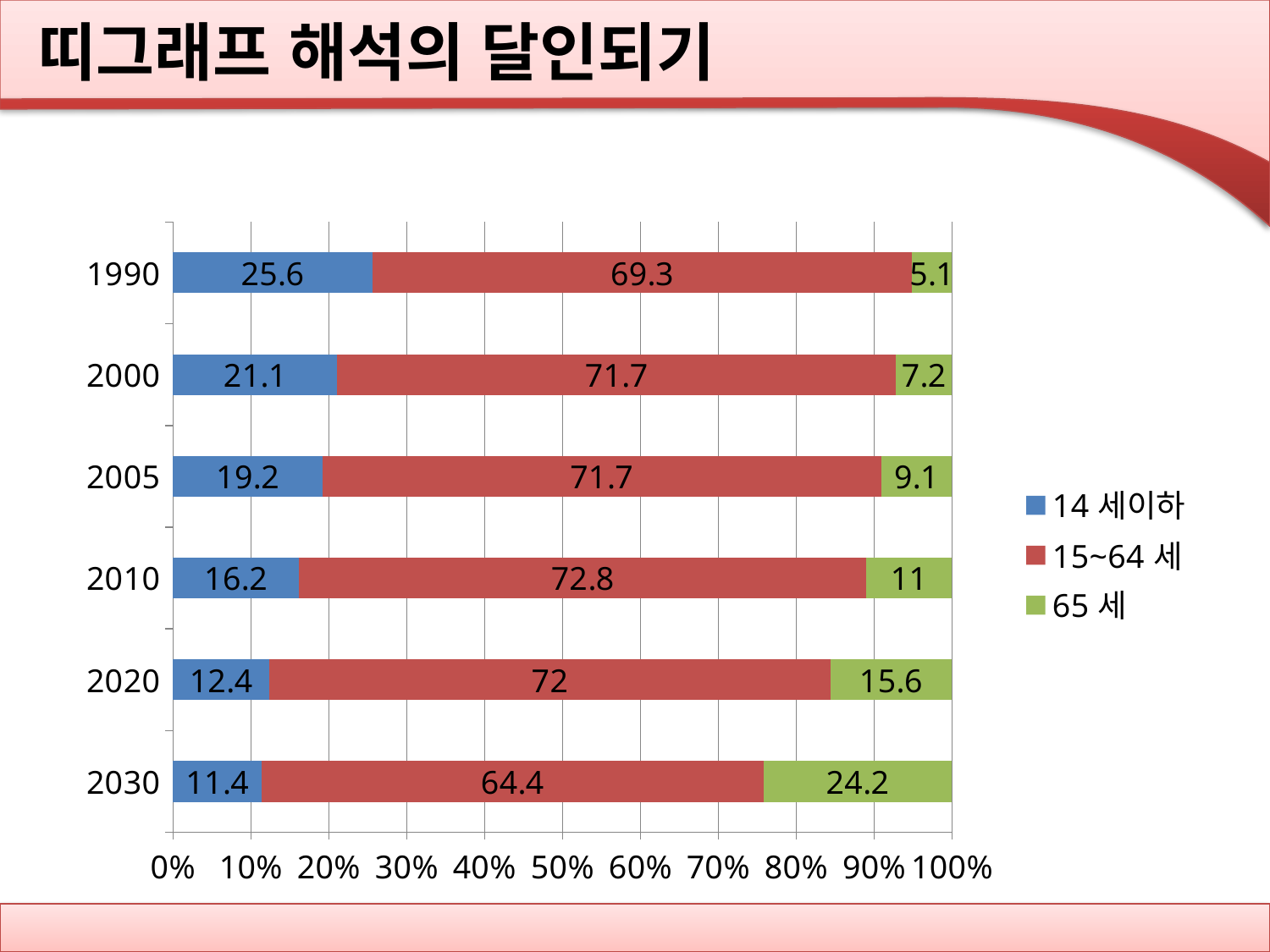
What colour represents the 65 세 series? Green Does the value for 14 세이하 rise or fall from 1990 to 2030? Fall Which year has the lowest value for 14 세이하? 2030 How many series does the legend list? 3 What is the value for 15~64 세 in 2010? 72.8 What kind of chart is shown on the slide? Stacked bar chart Which is larger, the 65 세 value for 2020 or for 2010? 2020 What is the value for 65 세 in 2030? 24.2 What is the value for 14 세이하 in 1990? 25.6 Which year has the highest value for 65 세? 2030 How many years are shown on the chart? 6 What is the difference between the 14 세이하 values for 1990 and 2030? 14.2